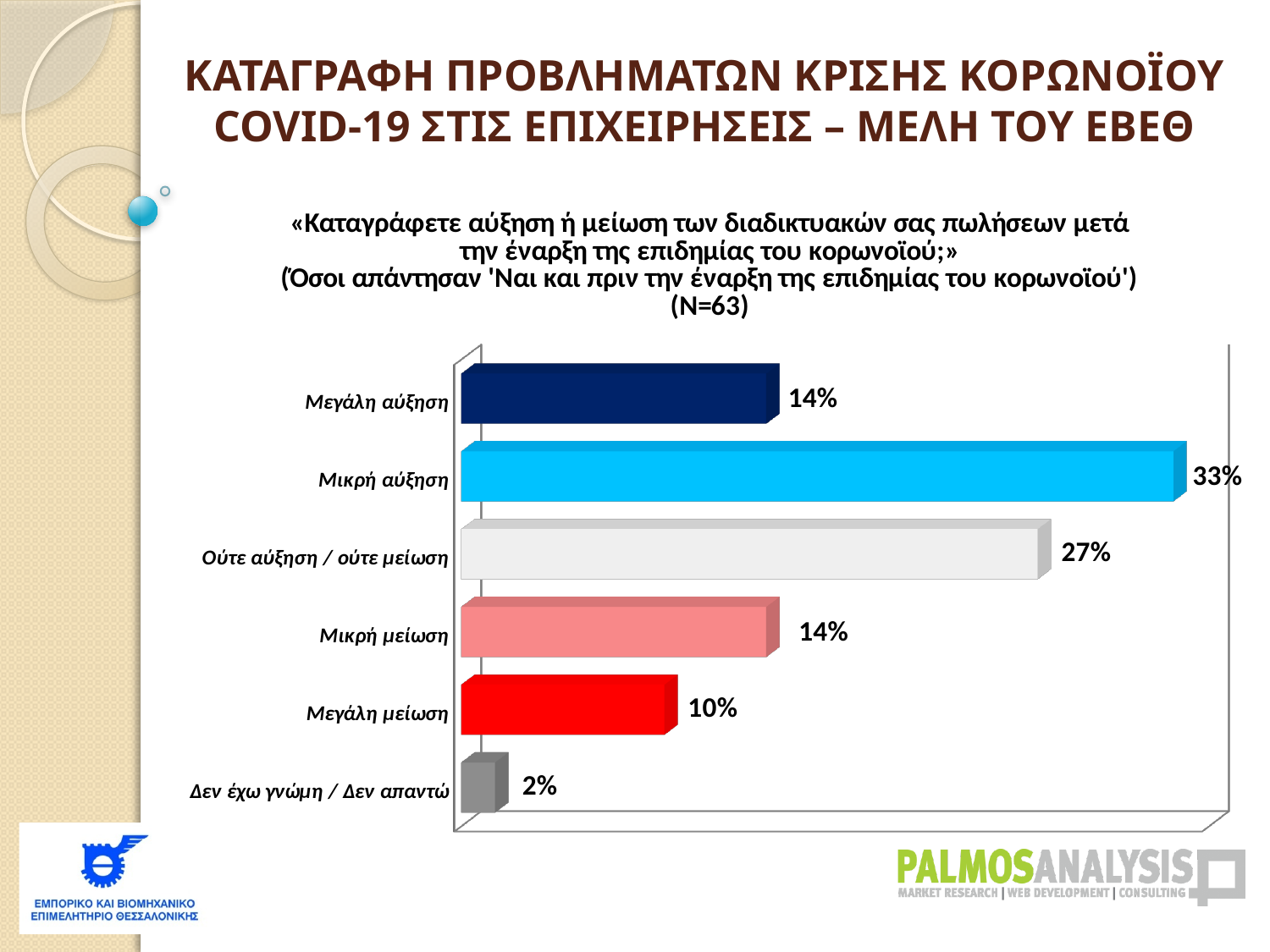
Which category has the highest value? Μικρή αύξηση What is the value for 'Δεν έχω γνώμη / Δεν απαντώ'? 2% Which category has the lowest value? Δεν έχω γνώμη / Δεν απαντώ What is the difference between 'Μικρή αύξηση' and 'Ούτε αύξηση / ούτε μείωση'? 6% What percentage is shown for 'Μεγάλη μείωση'? 10% What is the value shown for 'Ούτε αύξηση / ούτε μείωση'? 27% What percentage of respondents answered 'Μικρή αύξηση'? 33% What is the sample size (N) stated in the chart title? 63 How many categories are shown in the chart? 6 Which is larger, 'Ούτε αύξηση / ούτε μείωση' or 'Μικρή μείωση'? Ούτε αύξηση / ούτε μείωση What is the difference between 'Μεγάλη αύξηση' and 'Μεγάλη μείωση'? 4% What kind of chart is shown on the slide? Bar chart